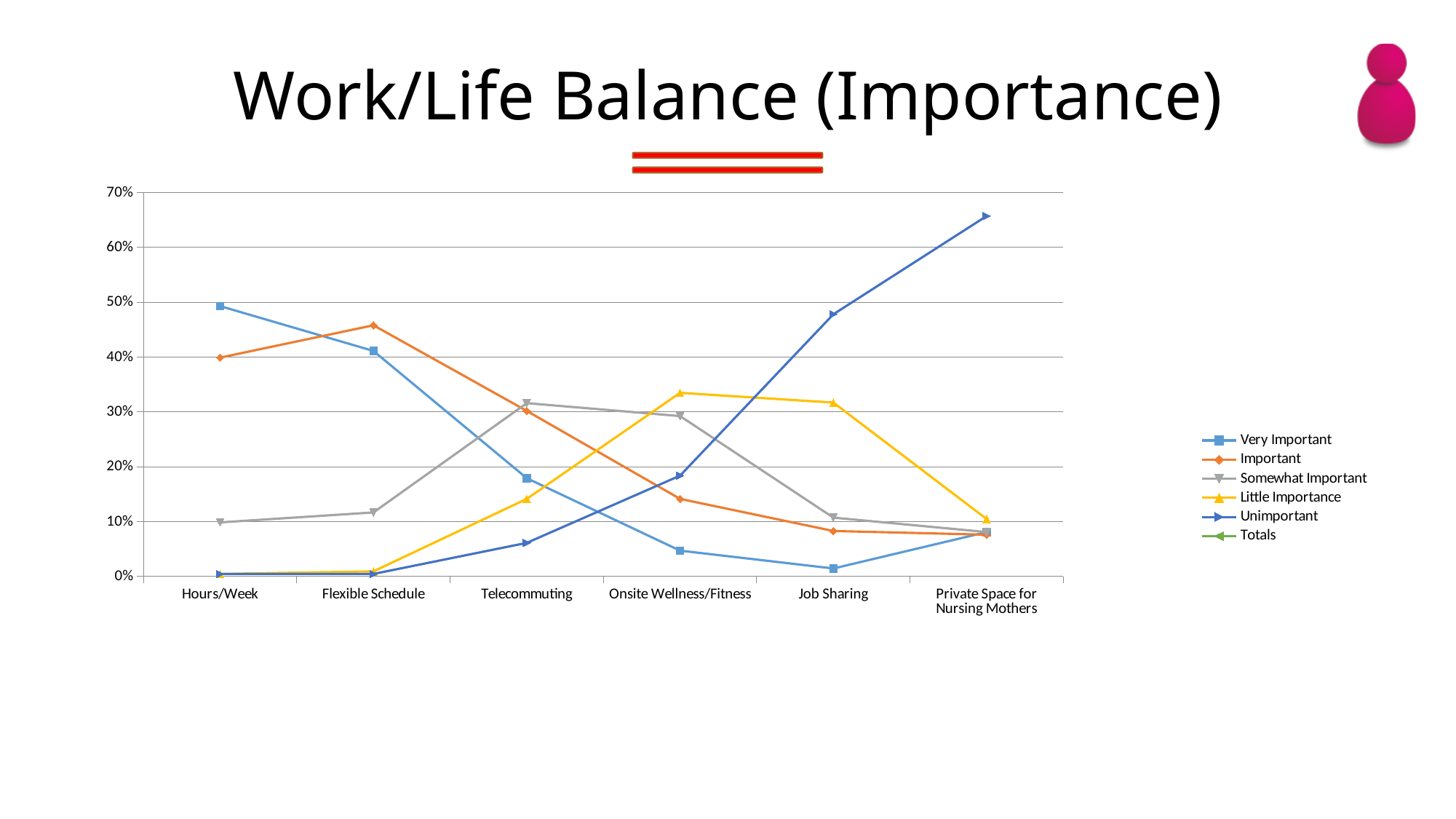
Does the Unimportant series rise or fall moving from Hours/Week to Private Space for Nursing Mothers? rise Is the Unimportant value for Private Space for Nursing Mothers greater or less than 60%? greater At Flexible Schedule, which is larger: the Important value or the Very Important value? Important Is the Very Important value for Hours/Week greater or less than 40%? greater How many categories are shown along the x axis of the chart? 6 Is the Little Importance value for Onsite Wellness/Fitness greater or less than 30%? greater For which category is the Very Important series highest? Hours/Week What kind of chart is shown on the slide? line chart How many series does the chart's legend list? 6 Which series is plotted with the yellow line? Little Importance For which category is the Unimportant series highest? Private Space for Nursing Mothers For which category is the Very Important series lowest? Job Sharing